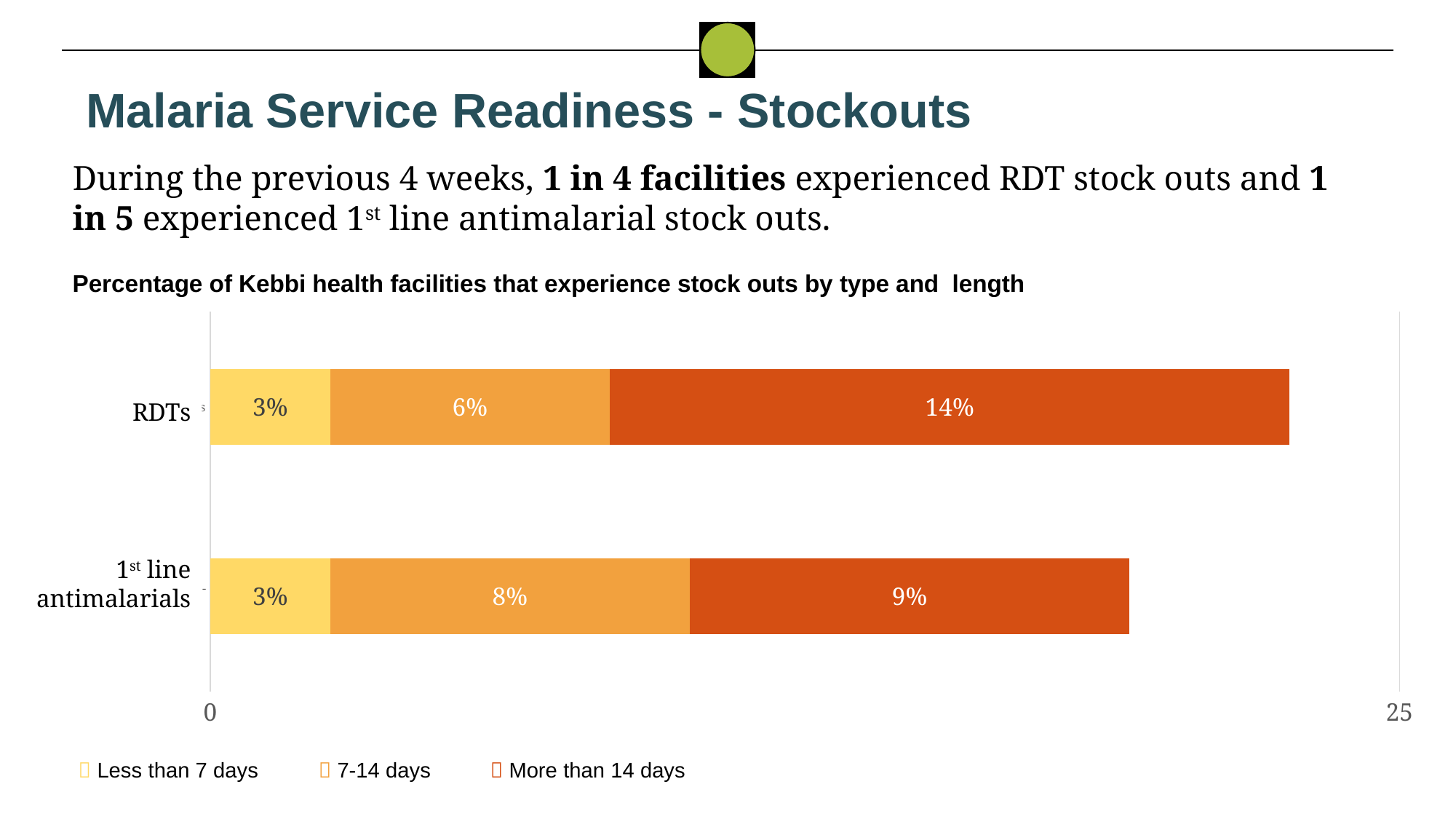
What is the value for '7-14 days' for 1st line antimalarials? 8% What is the total of the stacked bar for 1st line antimalarials? 20% How many series does the legend list? 3 What is the value for 'More than 14 days' for 1st line antimalarials? 9% Which is larger, the '7-14 days' value for RDTs or for 1st line antimalarials? 1st line antimalarials What is the value for 'More than 14 days' for RDTs? 14% How many categories are shown on the chart? 2 What is the title of the chart? Percentage of Kebbi health facilities that experience stock outs by type and length What is the difference between the 'More than 14 days' values for RDTs and 1st line antimalarials? 5% What type of chart is shown on the slide? Stacked bar chart What is the value for 'Less than 7 days' for RDTs? 3% What is the total of the stacked bar for RDTs? 23%